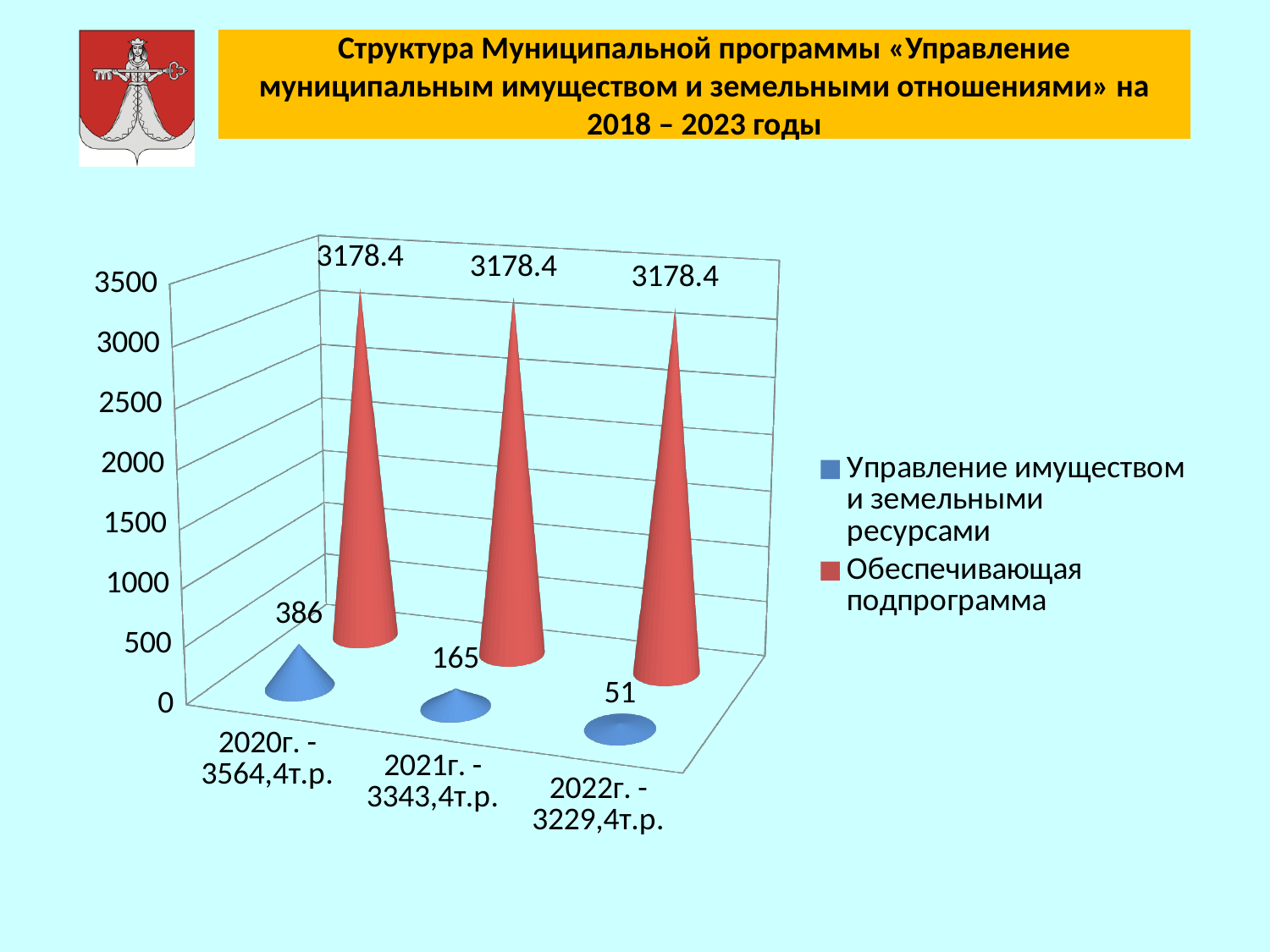
What is the value for «Управление имуществом и земельными ресурсами» in 2020? 386 What is the difference between the 2020 and 2021 values for «Управление имуществом и земельными ресурсами»? 221 How many series does the legend list? 2 In which year is the value for «Управление имуществом и земельными ресурсами» the highest? 2020 What kind of chart is shown on the slide? bar chart What is the value for «Управление имуществом и земельными ресурсами» in 2022? 51 How many years (categories) are shown on the x axis? 3 Does the value for «Управление имуществом и земельными ресурсами» rise or fall from 2020 to 2022? fall What colour represents «Обеспечивающая подпрограмма» in the chart? red In which year is the value for «Управление имуществом и земельными ресурсами» the lowest? 2022 What is the value for «Обеспечивающая подпрограмма» in 2021? 3178.4 Which series has the larger value in 2022: «Управление имуществом и земельными ресурсами» or «Обеспечивающая подпрограмма»? Обеспечивающая подпрограмма